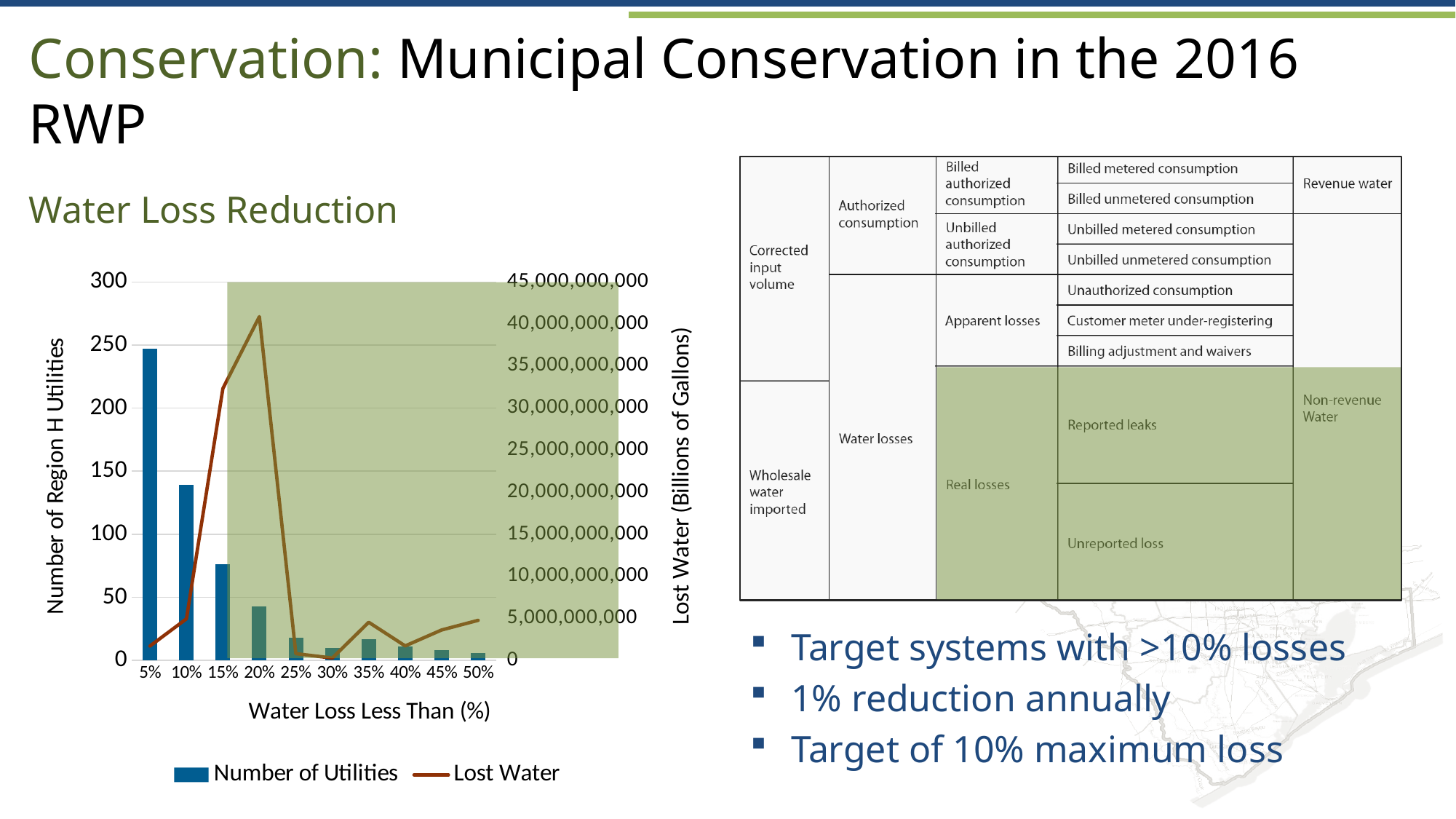
Do the Number of Utilities bars rise or fall from 5% to 25%? fall What is the title of the x axis of the Water Loss Reduction chart? Water Loss Less Than (%) What kind of chart is shown under "Water Loss Reduction"? A combined bar and line chart Which has the larger Number of Utilities, the 5% category or the 10% category? 5% How many series does the legend of the Water Loss Reduction chart list? 2 At which water loss category does the Lost Water line reach its peak? 20% Which water loss category has the highest Number of Utilities bar? 5% Is the Lost Water value at 25% greater or less than 5,000,000,000? less How many categories are shown on the x axis of the Water Loss Reduction chart? 10 Is the Number of Utilities for the 5% category greater or less than 200? greater Is the Number of Utilities for the 15% category greater or less than 100? less